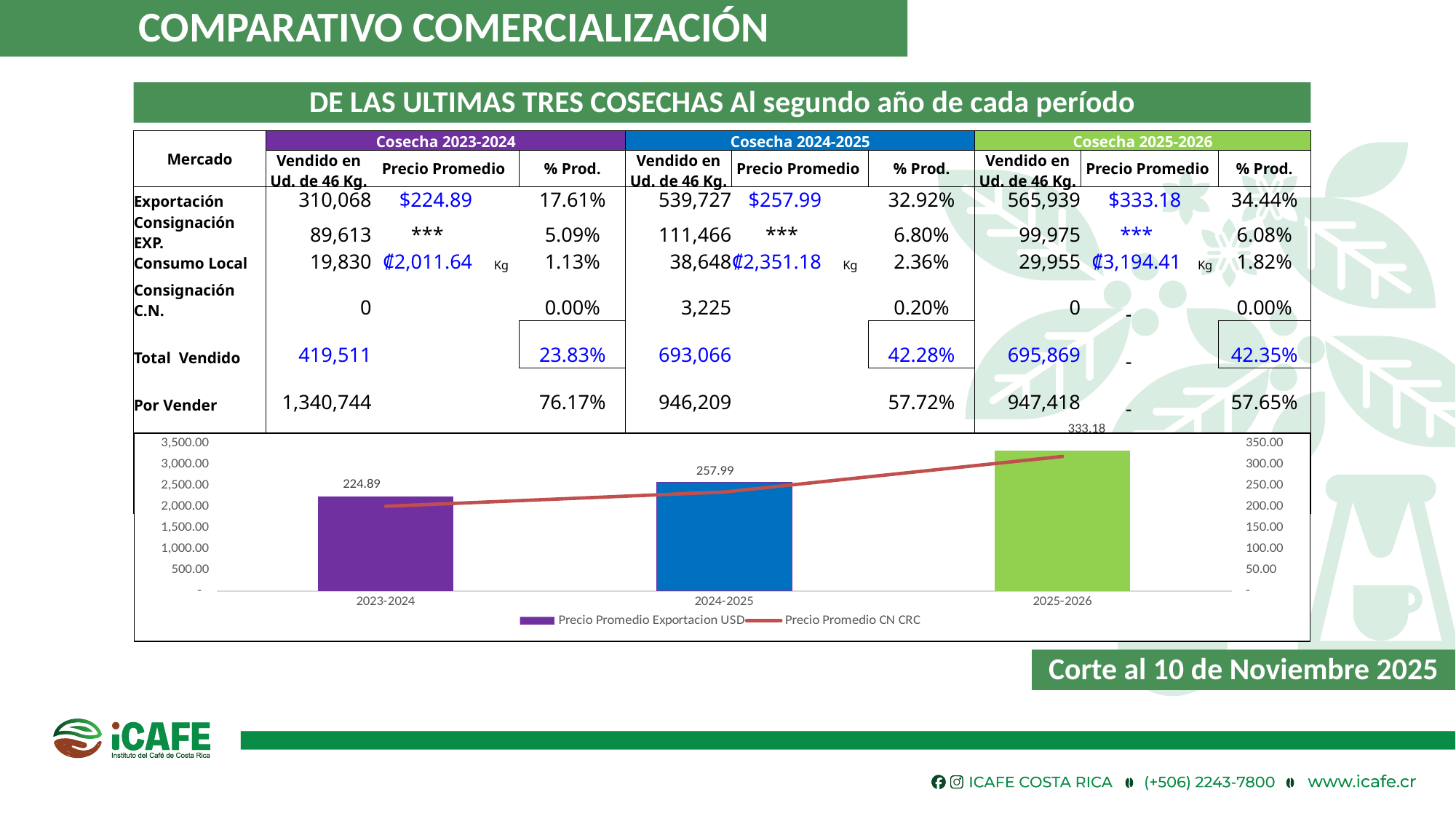
What kind of chart is shown at the bottom of the slide? Bar chart with a line What is the Precio Promedio Exportacion USD value for 2023-2024 in the chart? 224.89 What is the Precio Promedio Exportacion USD value for 2024-2025 in the chart? 257.99 How many series does the chart legend list? 2 In the chart, is the Precio Promedio Exportacion USD bar for 2024-2025 larger or smaller than the bar for 2025-2026? smaller What is the difference between the Precio Promedio Exportacion USD values for 2025-2026 and 2023-2024 in the chart? 108.29 Which harvest period has the lowest Precio Promedio Exportacion USD bar in the chart? 2023-2024 How many harvest periods are shown on the x axis of the chart? 3 What is the Precio Promedio Exportacion USD value for 2025-2026 in the chart? 333.18 Does the Precio Promedio CN CRC line rise or fall from 2023-2024 to 2025-2026 in the chart? rise What is the difference between the Precio Promedio Exportacion USD values for 2024-2025 and 2023-2024 in the chart? 33.10 Which harvest period has the highest Precio Promedio Exportacion USD bar in the chart? 2025-2026